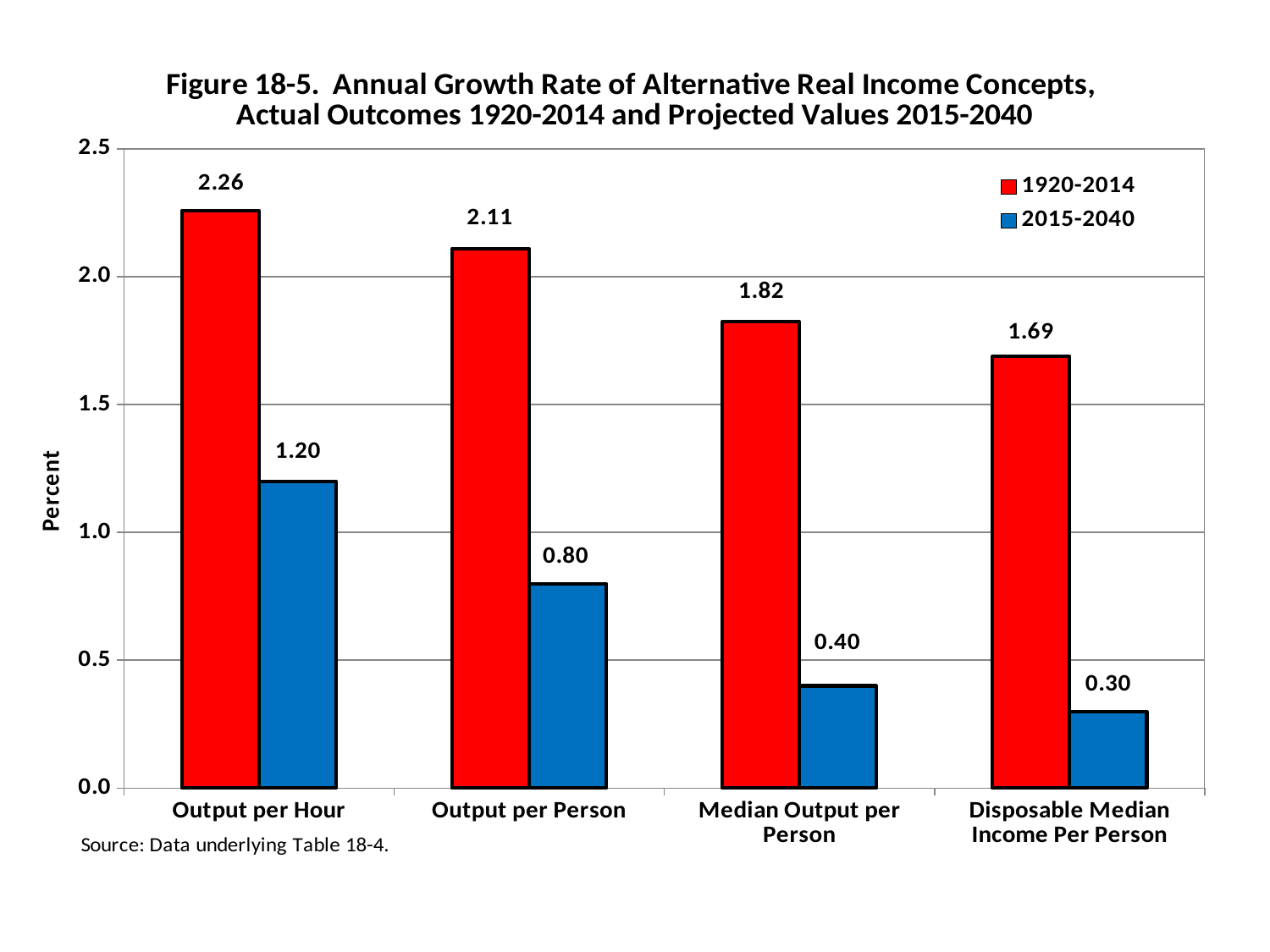
Which category has the lowest 2015-2040 value? Disposable Median Income Per Person Is the 1920-2014 value for Median Output per Person greater or less than 2.0? less Which is larger: the 2015-2040 value for Output per Hour or the 2015-2040 value for Output per Person? Output per Hour What is the 1920-2014 value for Output per Hour? 2.26 What is the difference between the 1920-2014 and 2015-2040 values for Output per Person? 1.31 How many categories are shown on the x axis? 4 Do the 1920-2014 values rise or fall from left to right across the categories? fall What is the 2015-2040 value for Median Output per Person? 0.40 What kind of chart is this? bar chart What is the 2015-2040 value for Disposable Median Income Per Person? 0.30 How many series does the legend list? 2 Which category has the highest 1920-2014 value? Output per Hour